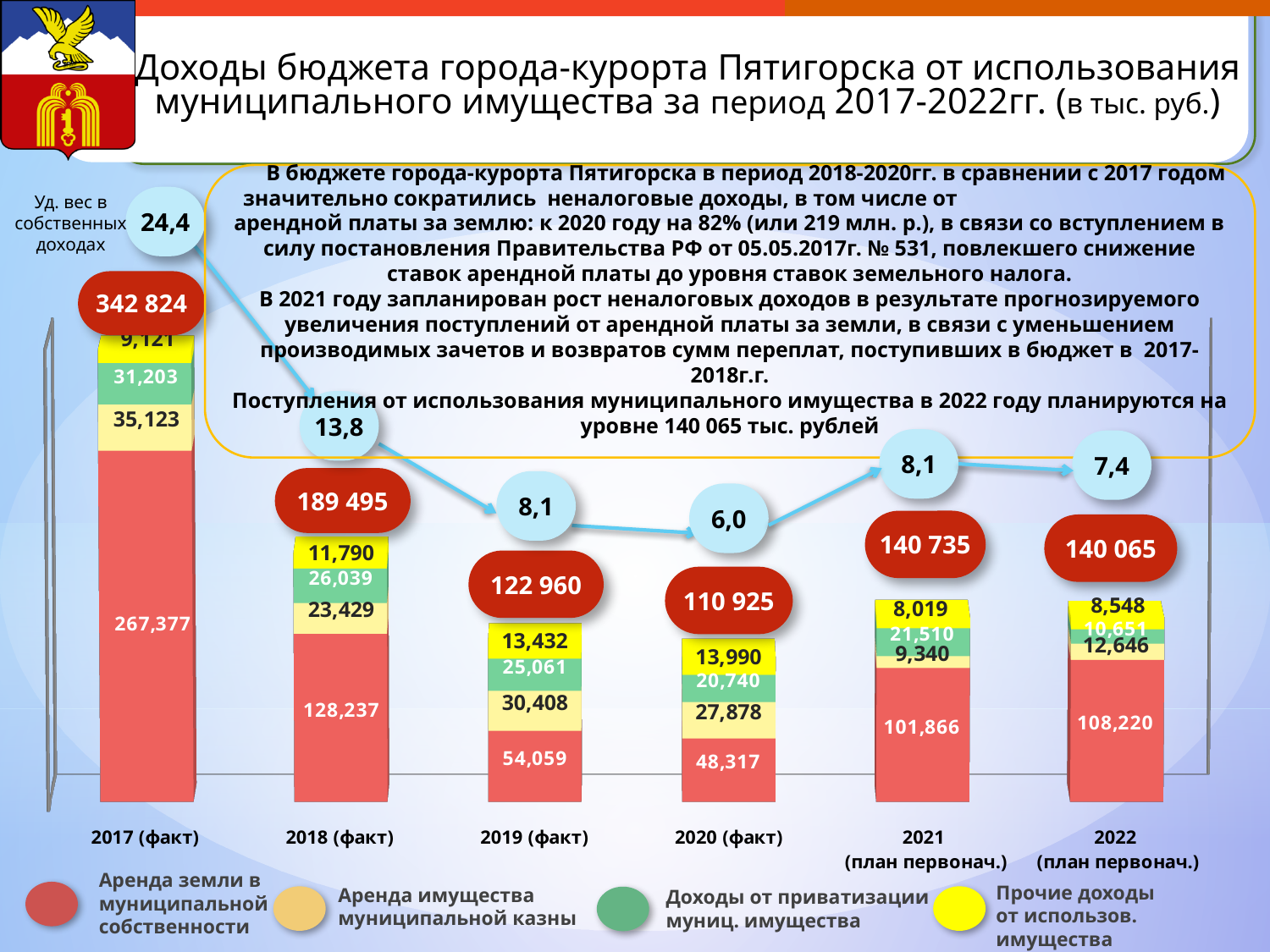
Which is larger: the 'Аренда земли в муниципальной собственности' value for 2019 (факт) or for 2020 (факт)? 2019 (факт) How many years (categories) are shown on the x axis? 6 What is the value for 'Прочие доходы от использов. имущества' in 2022 (план первонач.)? 8,548 What kind of chart is shown on the slide? Stacked bar chart What is the value for 'Доходы от приватизации муниц. имущества' in 2019 (факт)? 25,061 How many series does the legend list? 4 What is the value for 'Аренда земли в муниципальной собственности' in 2017 (факт)? 267,377 What is the difference between the 'Аренда земли в муниципальной собственности' values for 2017 (факт) and 2018 (факт)? 139,140 What is the total shown for the 2020 (факт) bar? 110 925 Which year has the highest total budget income from municipal property? 2017 (факт) Which year has the lowest total budget income from municipal property? 2020 (факт) Do the total values rise or fall from 2017 (факт) to 2020 (факт)? Fall